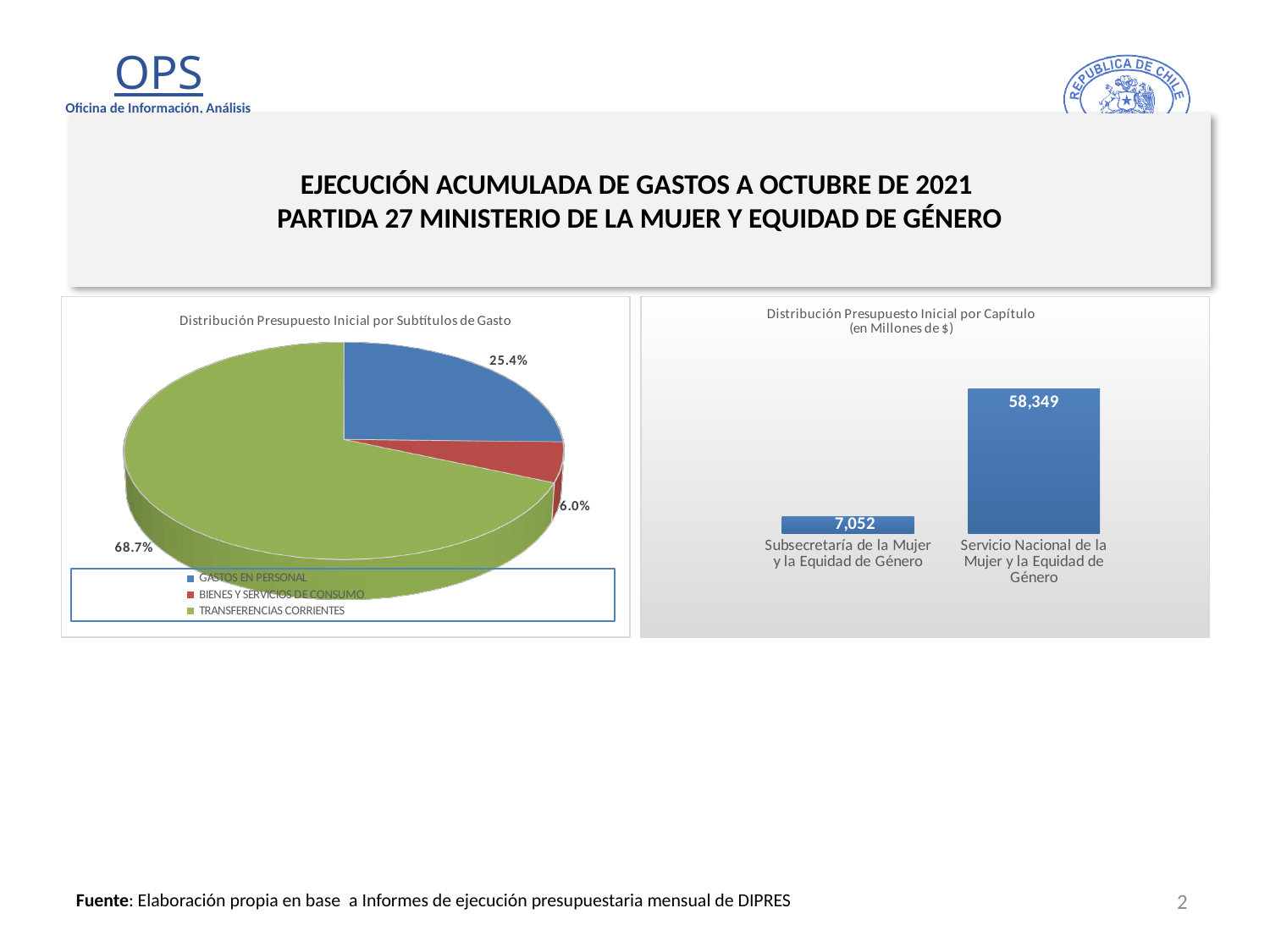
In the 'Distribución Presupuesto Inicial por Subtítulos de Gasto' chart, which category has the smallest slice? BIENES Y SERVICIOS DE CONSUMO What kind of chart is 'Distribución Presupuesto Inicial por Capítulo'? Bar chart In the 'Distribución Presupuesto Inicial por Capítulo' chart, which category has the higher value? Servicio Nacional de la Mujer y la Equidad de Género In the 'Distribución Presupuesto Inicial por Capítulo' chart, what is the difference between the two values? 51,297 In the 'Distribución Presupuesto Inicial por Capítulo' chart, what is the value for Servicio Nacional de la Mujer y la Equidad de Género? 58,349 How many categories does the legend of the 'Distribución Presupuesto Inicial por Subtítulos de Gasto' chart list? 3 In the 'Distribución Presupuesto Inicial por Subtítulos de Gasto' chart, what share does TRANSFERENCIAS CORRIENTES have? 68.7% What kind of chart is 'Distribución Presupuesto Inicial por Subtítulos de Gasto'? Pie chart In the 'Distribución Presupuesto Inicial por Subtítulos de Gasto' chart, which category has the largest slice? TRANSFERENCIAS CORRIENTES In the 'Distribución Presupuesto Inicial por Capítulo' chart, what is the value for Subsecretaría de la Mujer y la Equidad de Género? 7,052 In the 'Distribución Presupuesto Inicial por Subtítulos de Gasto' chart, what share does BIENES Y SERVICIOS DE CONSUMO have? 6.0% In the 'Distribución Presupuesto Inicial por Subtítulos de Gasto' chart, what share does GASTOS EN PERSONAL have? 25.4%